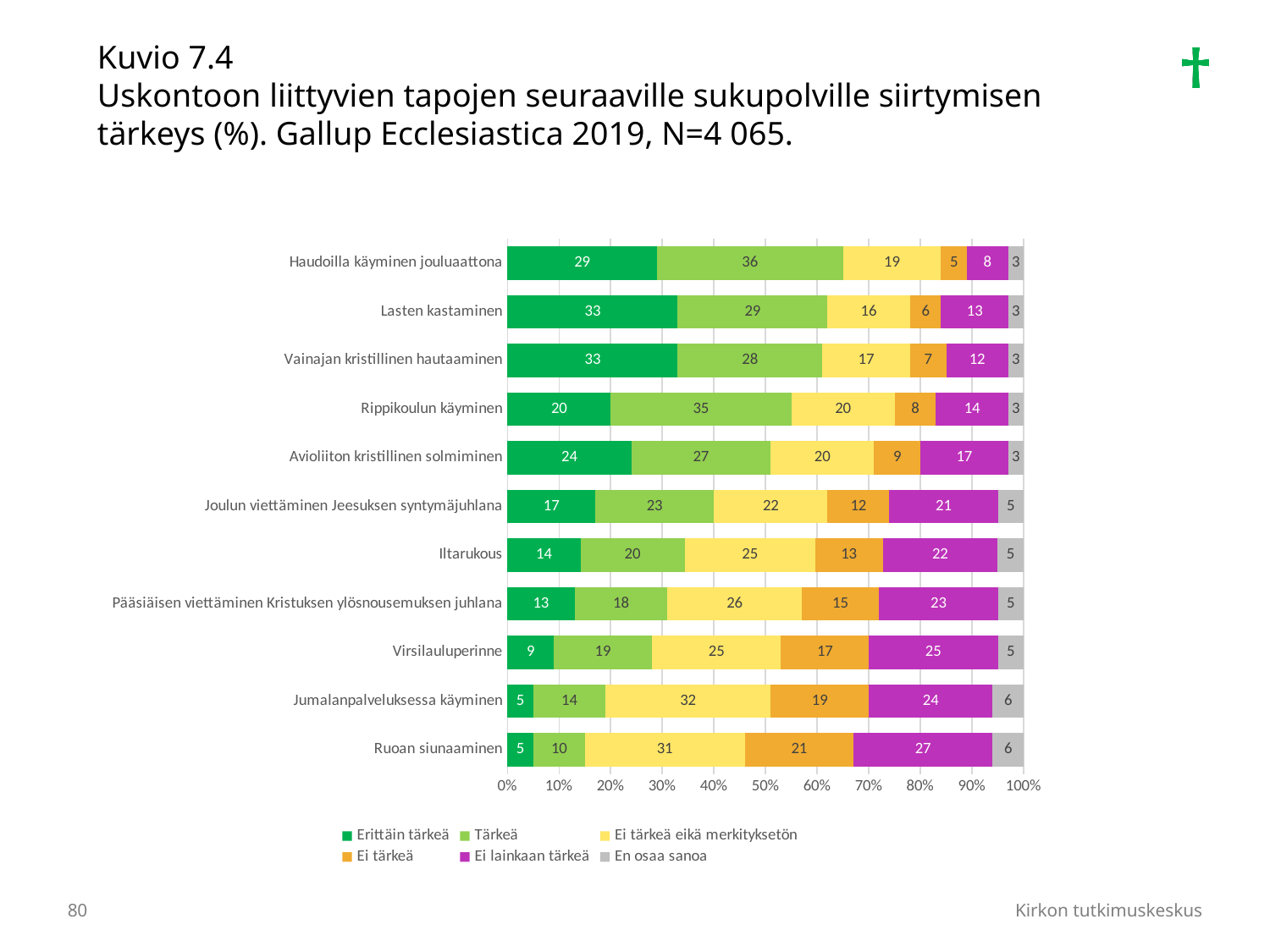
What is the 'Erittäin tärkeä' value for Haudoilla käyminen jouluaattona? 29 Which category has the lowest 'Tärkeä' value? Ruoan siunaaminen Which is larger: the 'Ei tärkeä' value for Virsilauluperinne or for Iltarukous? Virsilauluperinne Which category has the highest 'Tärkeä' value? Haudoilla käyminen jouluaattona What is the total of the stacked bar for Haudoilla käyminen jouluaattona? 100 What is the 'Ei tärkeä eikä merkityksetön' value for Jumalanpalveluksessa käyminen? 32 Which category has the highest 'Ei lainkaan tärkeä' value? Ruoan siunaaminen What kind of chart is shown on the slide? Stacked bar chart How many categories (religious customs) are shown in the chart? 11 How many series does the legend list? 6 What is the difference between the 'Erittäin tärkeä' values for Lasten kastaminen and Rippikoulun käyminen? 13 What is the 'Ei lainkaan tärkeä' value for Ruoan siunaaminen? 27